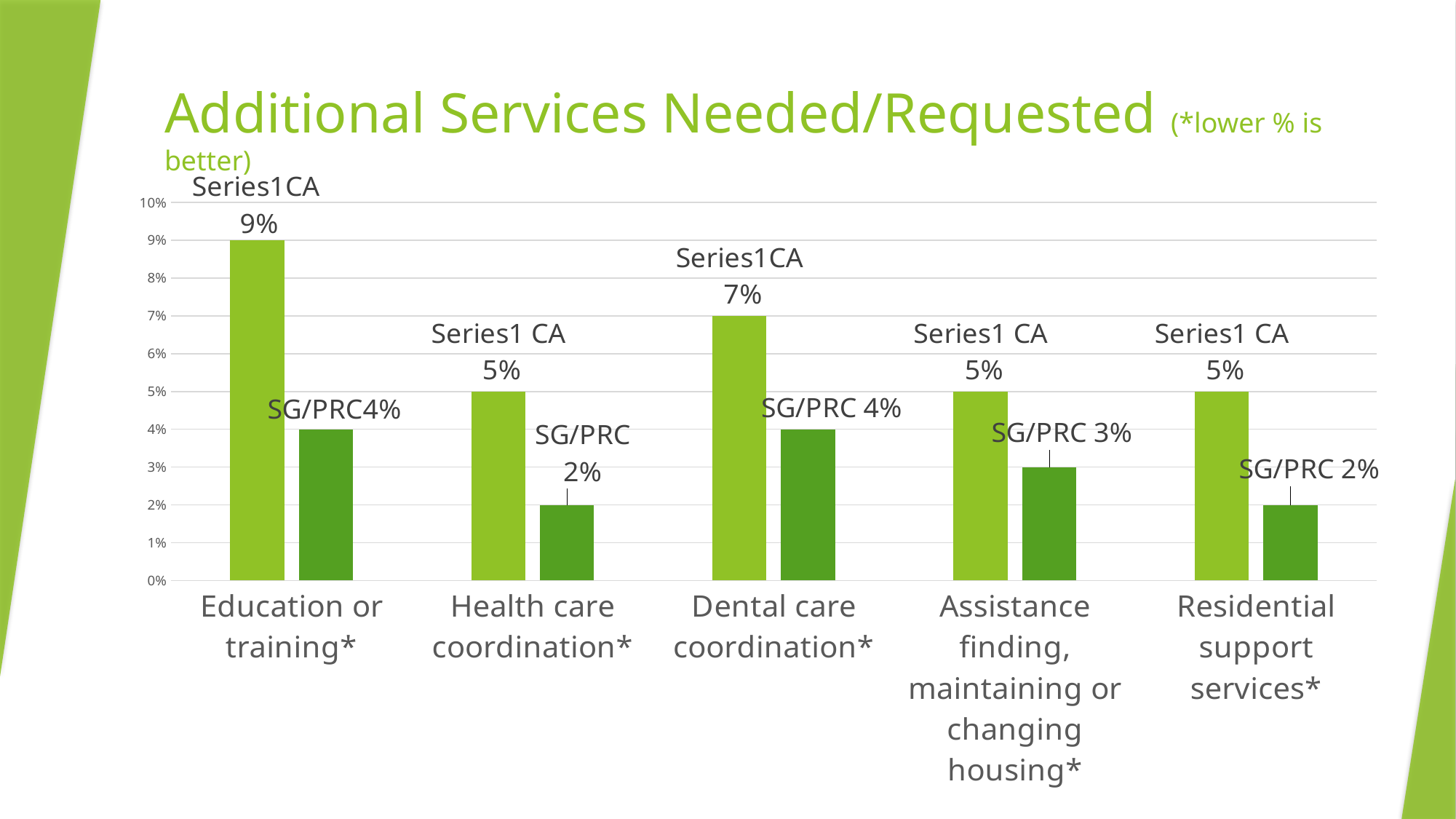
What is the CA value for Dental care coordination? 7% What kind of chart is shown on the slide? Bar chart Which is larger, the CA value for Dental care coordination or the CA value for Residential support services? CA value for Dental care coordination What is the SG/PRC value for Health care coordination? 2% What is the difference between the CA and SG/PRC values for Dental care coordination? 3% Which category has the highest CA value? Education or training What is the title of the chart on the slide? Additional Services Needed/Requested (*lower % is better) How many categories are shown on the x axis? 5 What is the SG/PRC value for Assistance finding, maintaining or changing housing? 3% What is the CA value for Education or training? 9% What is the difference between the CA and SG/PRC values for Education or training? 5% Which category has the lowest CA value among those with a unique lowest? If none, which categories tie for the lowest CA value? Health care coordination, Assistance finding, maintaining or changing housing, and Residential support services (all 5%)